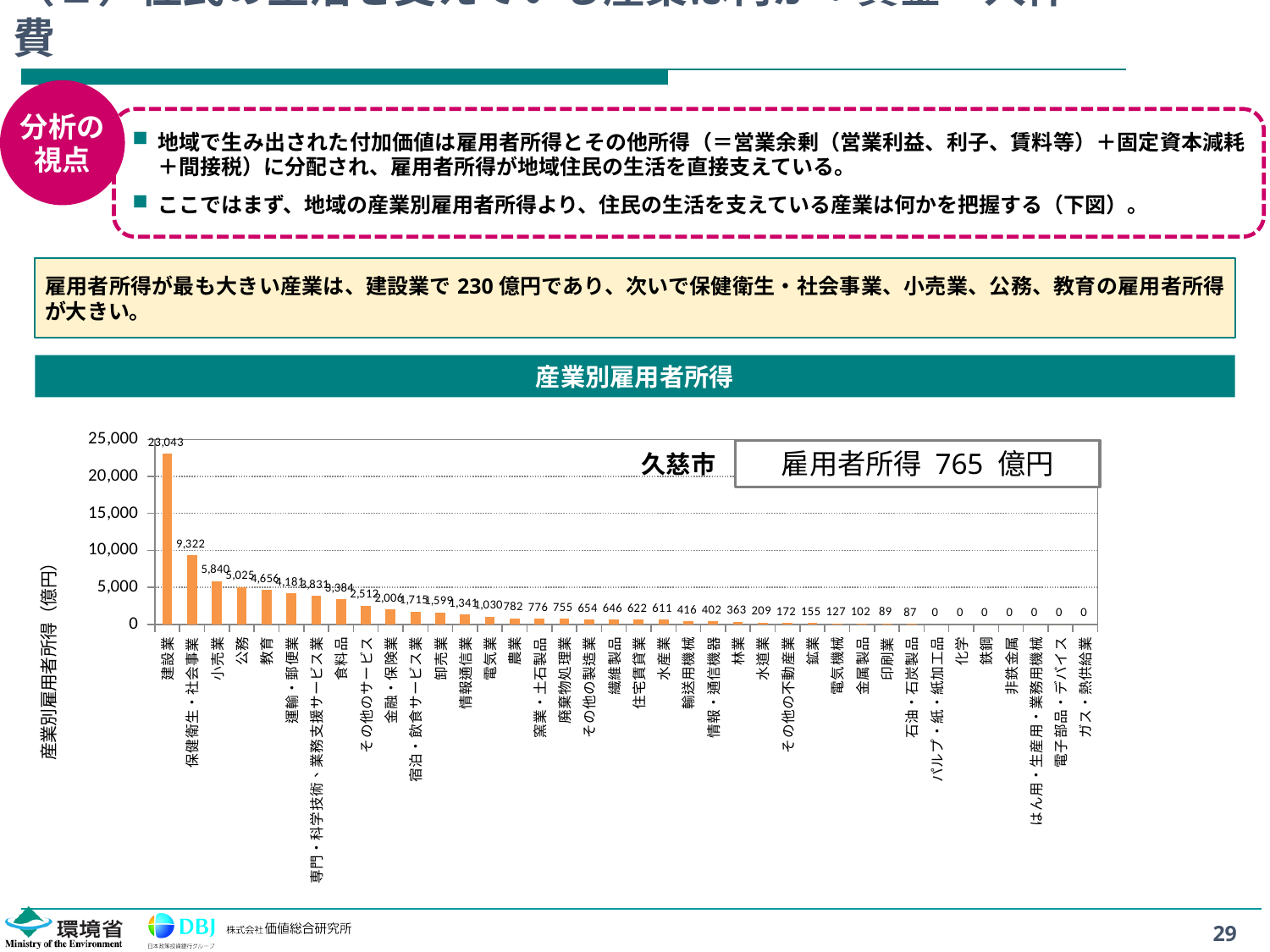
Which is larger, 公務 or 教育? 公務 How many industries have a value of 0? 7 What is the value for 保健衛生・社会事業? 9,322 What type of chart is shown on the slide? bar chart What is the title of the chart? 産業別雇用者所得 What is the value for 林業? 363 What is the value for 小売業? 5,840 What is the difference between 建設業 and 保健衛生・社会事業? 13,721 Which industry has the highest value? 建設業 What is the value for 農業? 782 Is the value for 保健衛生・社会事業 greater or less than 10,000? less What is the value for 建設業? 23,043